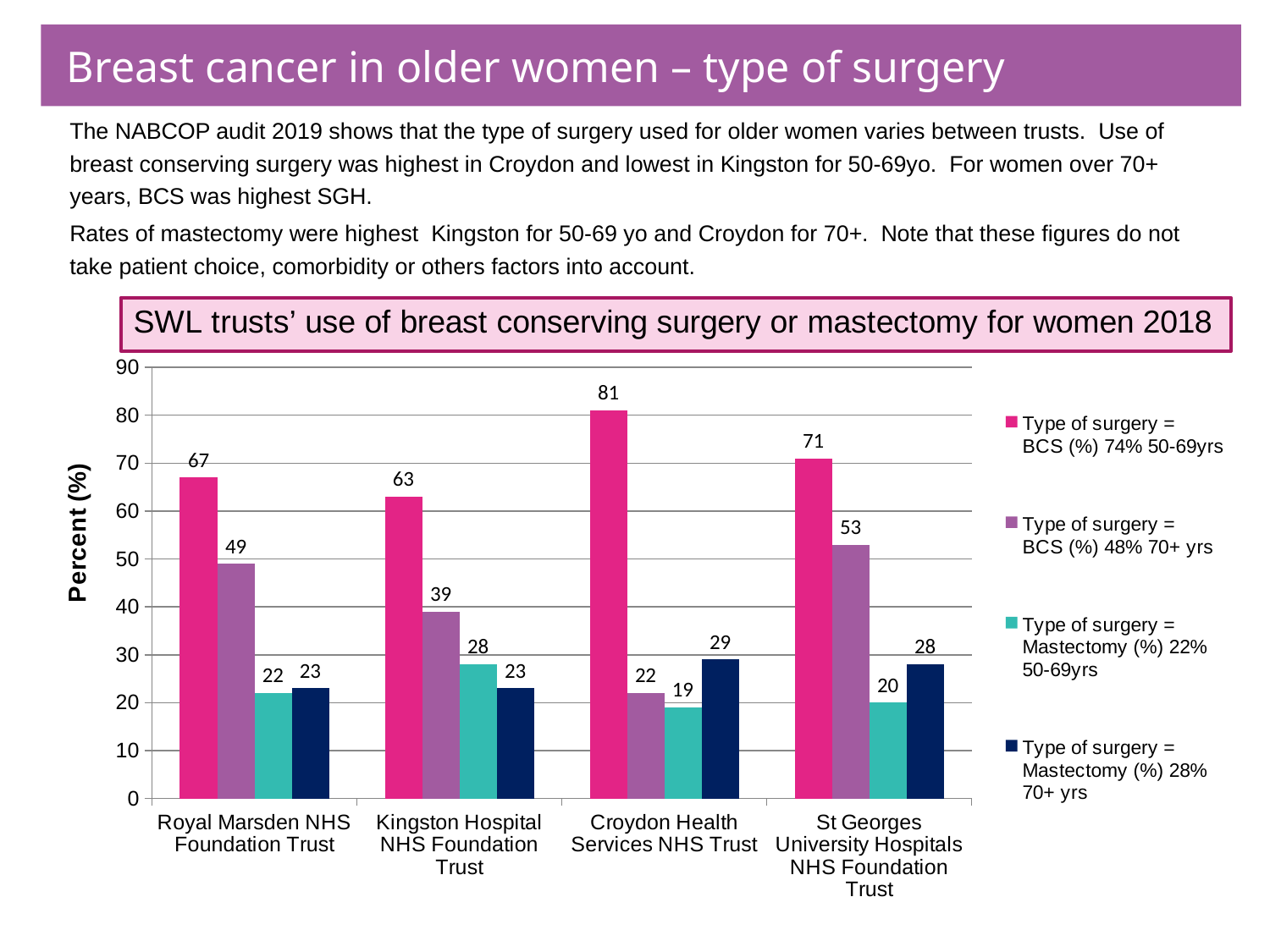
What is the Mastectomy (%) value for women aged 50-69 years at Kingston Hospital NHS Foundation Trust? 28 How many trusts are shown on the x axis of the chart? 4 Which trust has the highest BCS (%) value for women aged 50-69 years? Croydon Health Services NHS Trust Is the BCS (%) value for women aged 70+ years at Kingston Hospital NHS Foundation Trust greater or less than 40? less What is the BCS (%) value for women aged 50-69 years at Croydon Health Services NHS Trust? 81 Which trust has the lowest BCS (%) value for women aged 70+ years? Croydon Health Services NHS Trust What is the title of the chart? SWL trusts' use of breast conserving surgery or mastectomy for women 2018 What is the BCS (%) value for women aged 70+ years at St Georges University Hospitals NHS Foundation Trust? 53 What is the difference between the BCS (%) values for women aged 50-69 years and 70+ years at Royal Marsden NHS Foundation Trust? 18 How many series does the chart legend list? 4 Which is larger at Kingston Hospital NHS Foundation Trust: the Mastectomy (%) for 50-69 years or the Mastectomy (%) for 70+ years? Mastectomy (%) 50-69yrs What type of chart is shown on the slide? Bar chart